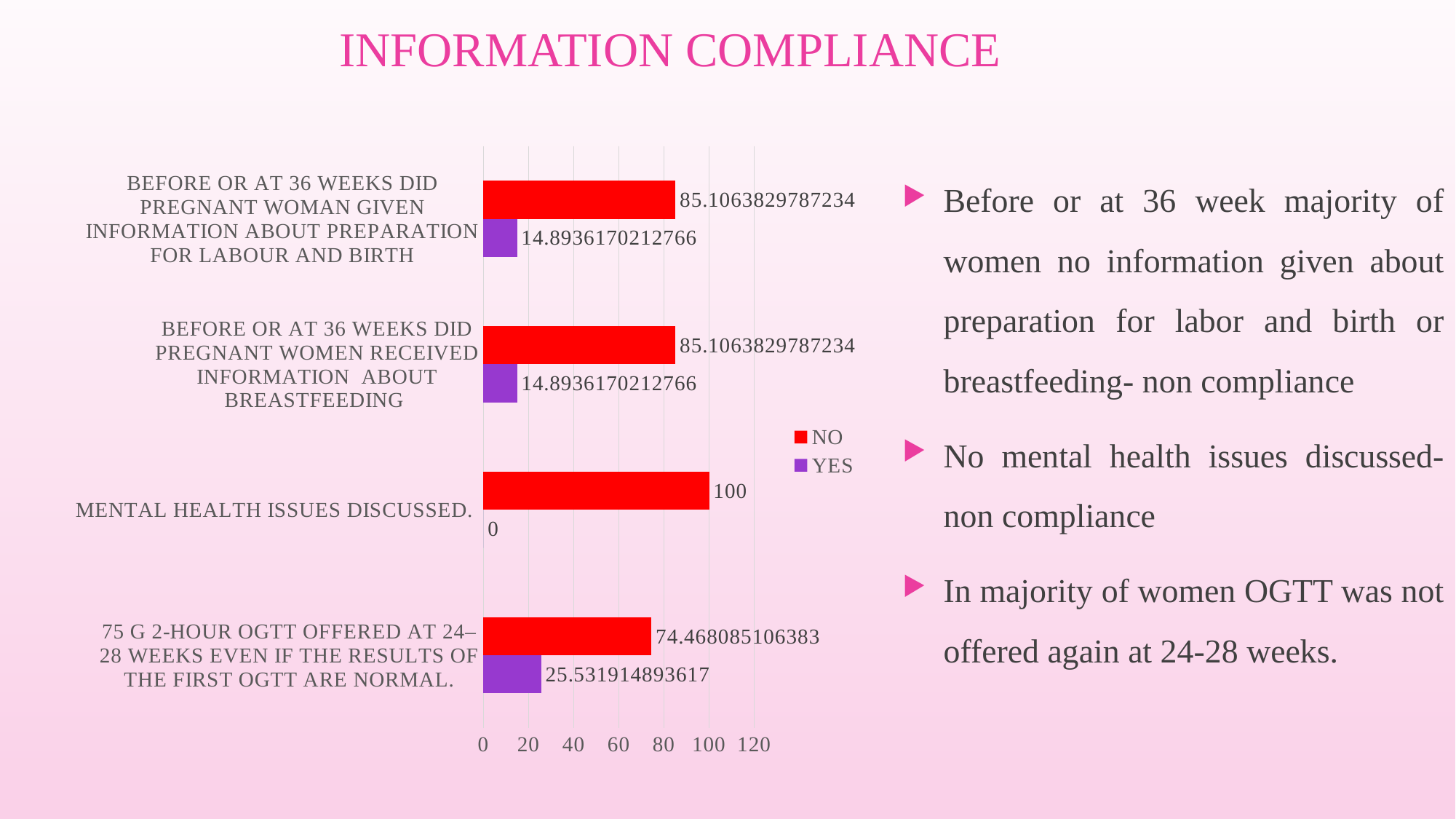
What is the NO value for 'Before or at 36 weeks did pregnant women received information about breastfeeding'? 85.1063829787234 What is the YES value for 'Before or at 36 weeks did pregnant woman given information about preparation for labour and birth'? 14.8936170212766 What is the NO value for 'Mental health issues discussed.'? 100 How many series does the legend list? 2 What is the NO value for '75 g 2-hour OGTT offered at 24–28 weeks even if the results of the first OGTT are normal.'? 74.468085106383 How many categories are shown on the chart? 4 Which is larger for the OGTT category, the NO value or the YES value? NO What kind of chart is shown on the slide? Bar chart Which category has the highest NO value? Mental health issues discussed. What is the YES value for 'Mental health issues discussed.'? 0 What is the YES value for '75 g 2-hour OGTT offered at 24–28 weeks even if the results of the first OGTT are normal.'? 25.5319148936617 Which category has the lowest YES value? Mental health issues discussed.